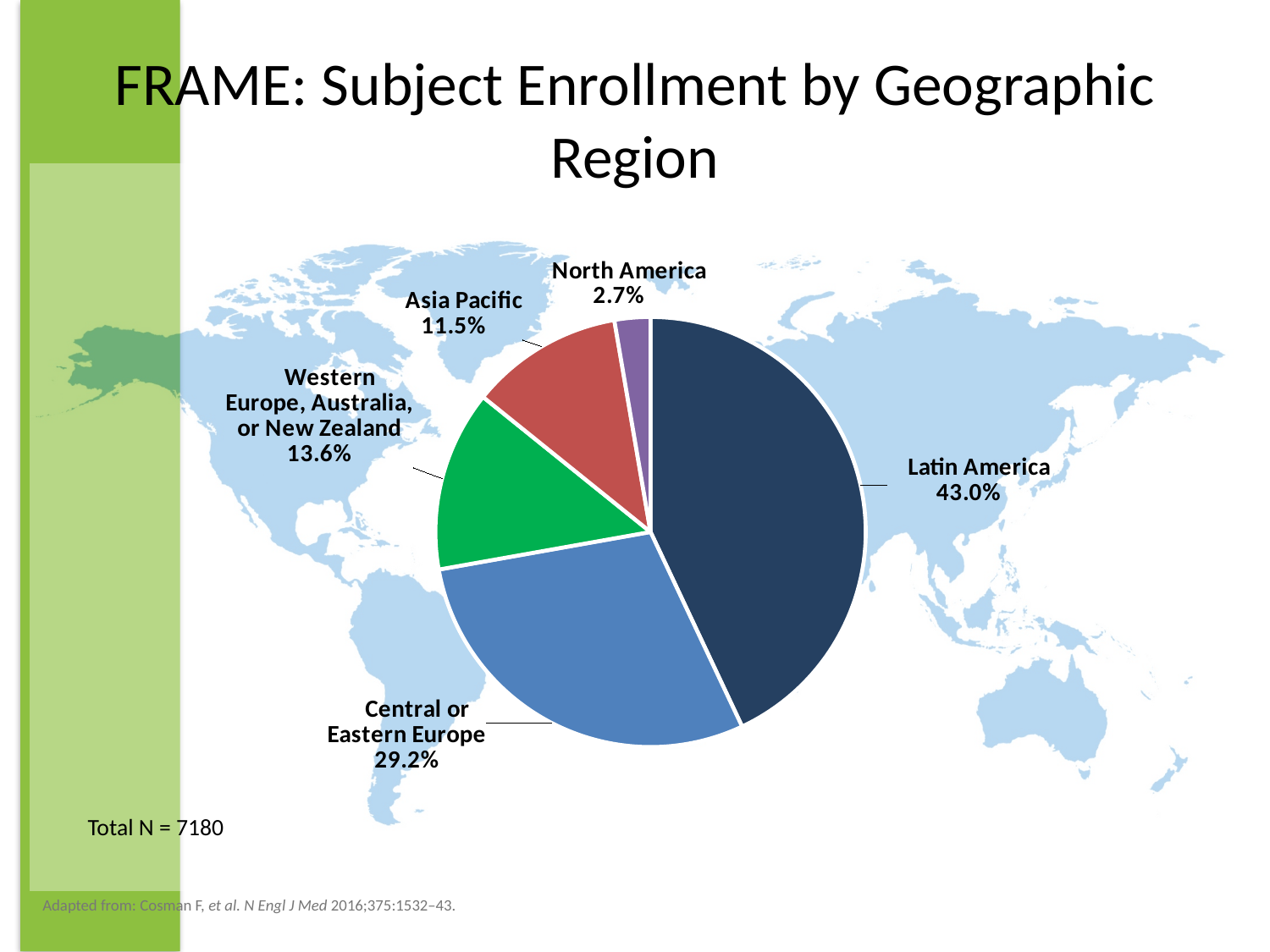
What share of subject enrollment is from North America? 2.7% Which geographic region has the smallest share of enrollment? North America What is the total N stated on the slide? 7180 What type of chart is shown on the slide? Pie chart What share of subject enrollment is from Asia Pacific? 11.5% What share of subject enrollment is from Western Europe, Australia, or New Zealand? 13.6% Which geographic region has the largest share of enrollment? Latin America What share of subject enrollment is from Central or Eastern Europe? 29.2% How many geographic regions are shown in the pie chart? 5 Which has a larger share of enrollment, Asia Pacific or Western Europe, Australia, or New Zealand? Western Europe, Australia, or New Zealand What share of subject enrollment is from Latin America? 43.0% What is the difference in percentage points between Latin America and Central or Eastern Europe? 13.8